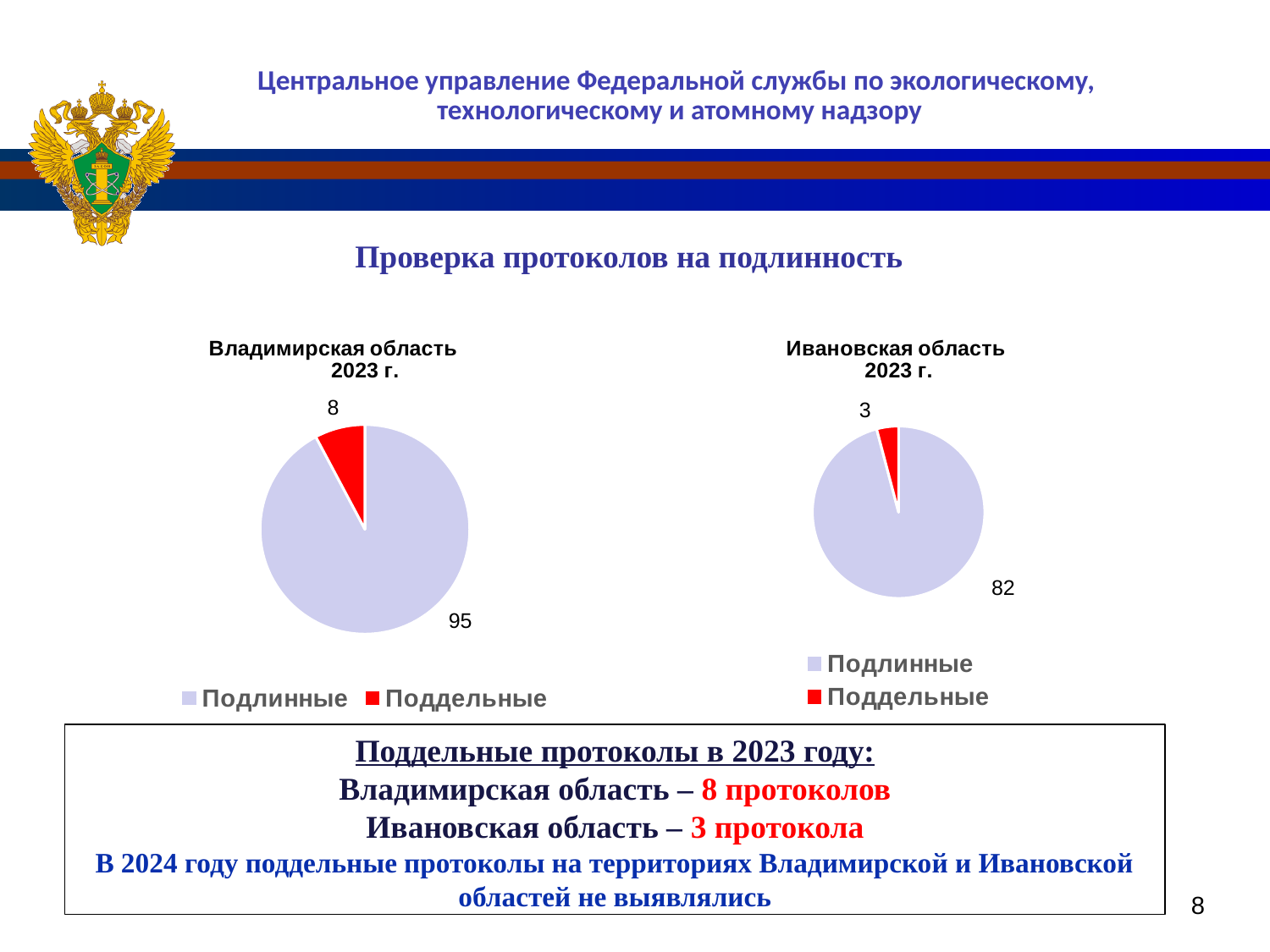
Which chart has the larger value for Поддельные, 'Владимирская область 2023 г.' or 'Ивановская область 2023 г.'? Владимирская область 2023 г. In the 'Владимирская область 2023 г.' pie chart, which slice is the largest? Подлинные In the 'Владимирская область 2023 г.' pie chart, what is the difference between Подлинные and Поддельные? 87 What type of chart is used for 'Ивановская область 2023 г.'? Pie chart How many entries does the legend of the 'Владимирская область 2023 г.' chart list? 2 In the 'Ивановская область 2023 г.' pie chart, what is the value for Поддельные? 3 In the 'Ивановская область 2023 г.' pie chart, what is the value for Подлинные? 82 In the 'Владимирская область 2023 г.' pie chart, what is the value for Подлинные? 95 In the 'Ивановская область 2023 г.' pie chart, which slice is the smallest? Поддельные What is the total of all slices in the 'Владимирская область 2023 г.' pie chart? 103 In the 'Владимирская область 2023 г.' pie chart, what is the value for Поддельные? 8 In the 'Ивановская область 2023 г.' pie chart, what is the difference between Подлинные and Поддельные? 79